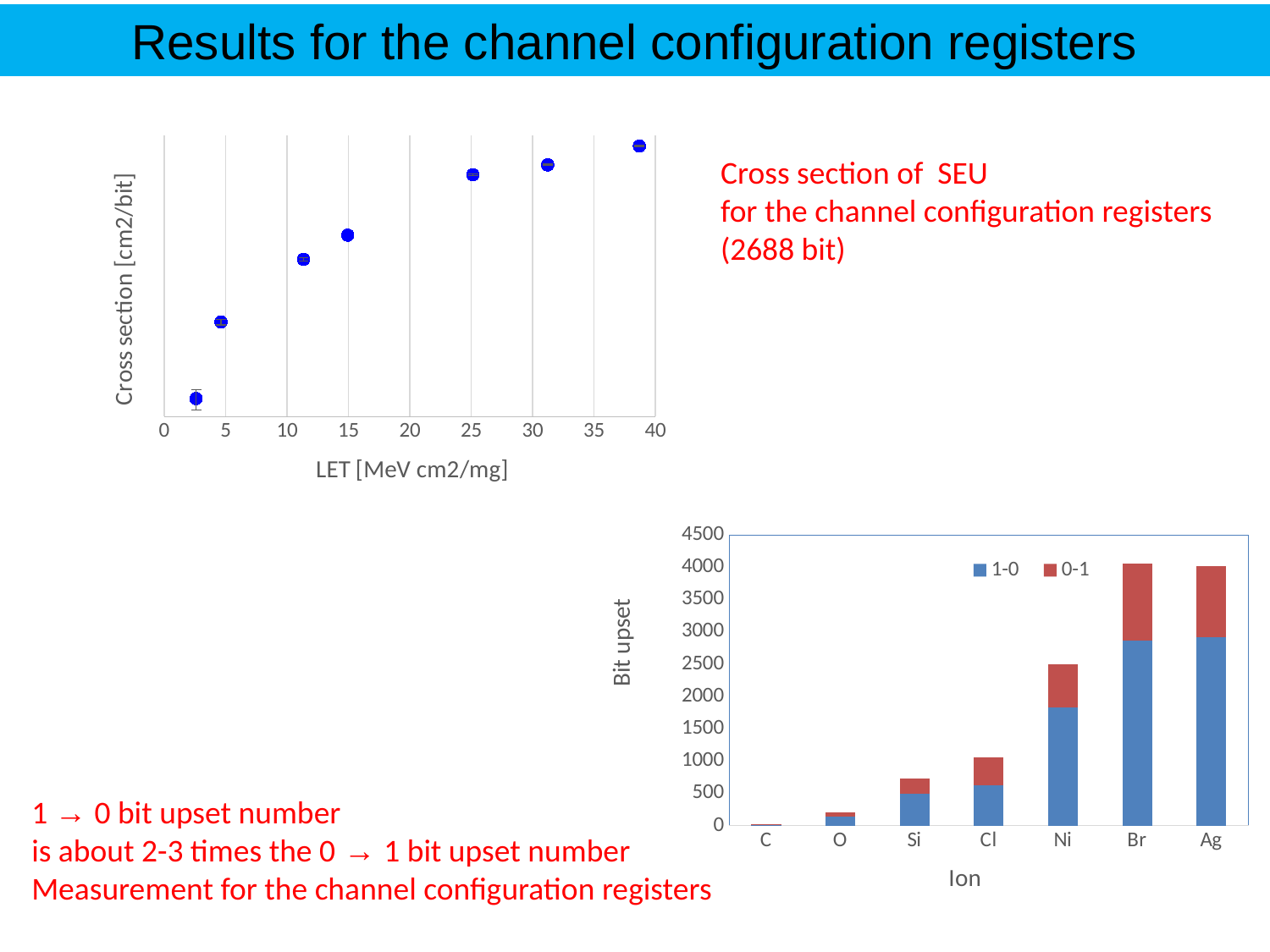
In the bottom-right Bit upset chart, which ion has the lowest total bit upset? C In the bottom-right Bit upset chart, is the total bit upset for Ni greater or less than 2000? greater What kind of chart is the bottom-right chart with the x axis labelled Ion? stacked bar chart What kind of chart is the top-left chart with the x axis labelled LET [MeV cm2/mg]? scatter plot In the top-left cross section chart, how many data points are plotted? 7 In the bottom-right Bit upset chart, how many series does the legend list? 2 In the bottom-right Bit upset chart, is the total bit upset for Br greater or less than 3500? greater In the bottom-right Bit upset chart, do the total bit upsets generally rise or fall from C to Ag along the x axis? rise In the bottom-right Bit upset chart, which has the larger total bit upset, Ni or Cl? Ni In the bottom-right Bit upset chart, is the total bit upset for O greater or less than 500? less In the bottom-right Bit upset chart, how many ions are shown on the x axis? 7 In the top-left cross section chart, does the cross section rise or fall as LET increases? rise